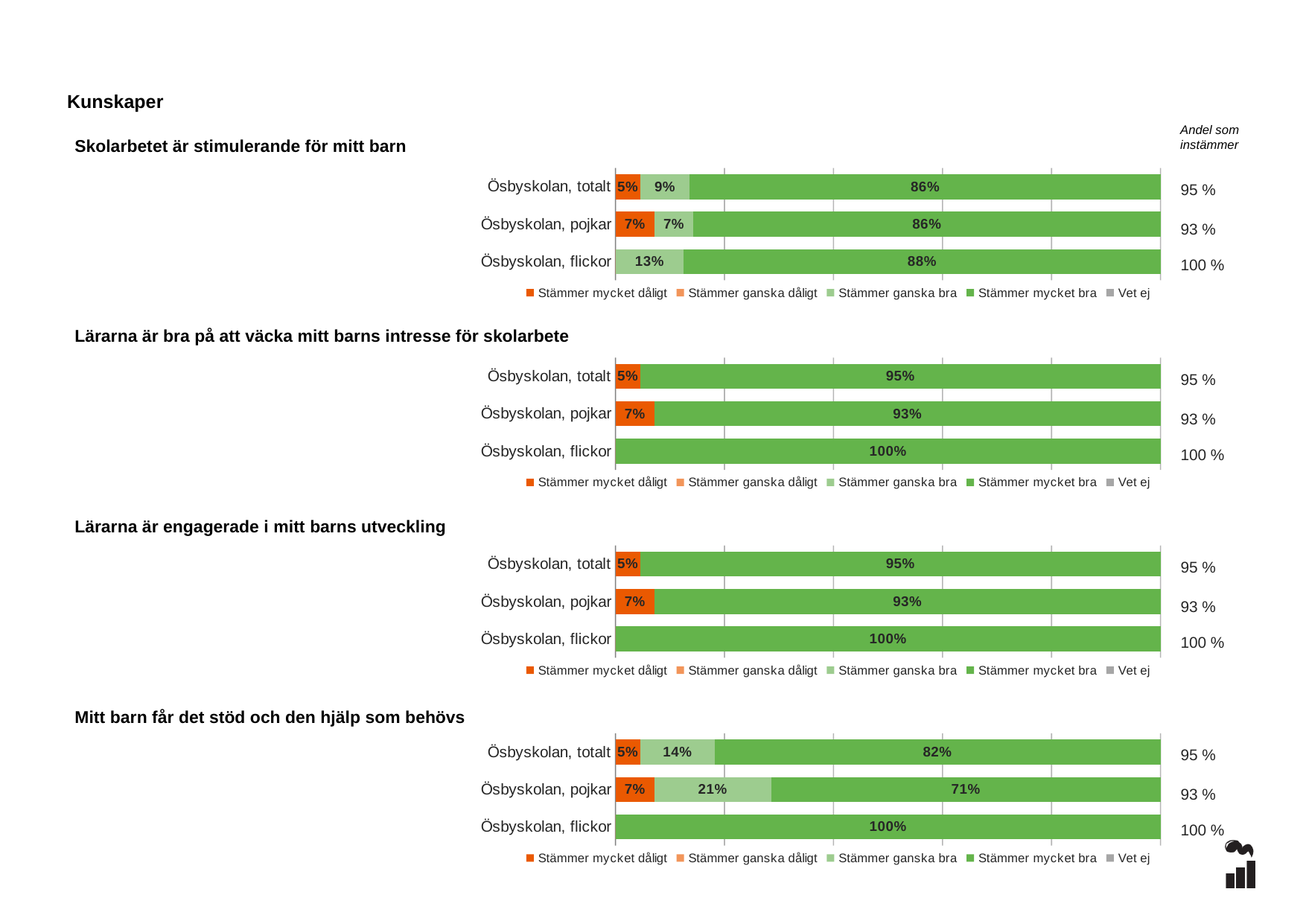
In the chart 'Mitt barn får det stöd och den hjälp som behövs', which category has the highest 'Stämmer mycket bra' value? Ösbyskolan, flickor In the chart 'Skolarbetet är stimulerande för mitt barn', what is the 'Stämmer mycket bra' value for Ösbyskolan, flickor? 88% In the chart 'Lärarna är engagerade i mitt barns utveckling', what is the 'Stämmer mycket dåligt' value for Ösbyskolan, pojkar? 7% In the chart 'Lärarna är bra på att väcka mitt barns intresse för skolarbete', which is larger: the 'Stämmer mycket bra' value for Ösbyskolan, totalt or for Ösbyskolan, pojkar? Ösbyskolan, totalt In the chart 'Mitt barn får det stöd och den hjälp som behövs', which category has the lowest 'Stämmer mycket bra' value? Ösbyskolan, pojkar How many series does the legend of the chart 'Skolarbetet är stimulerande för mitt barn' list? 5 In the chart 'Mitt barn får det stöd och den hjälp som behövs', what is the difference between the 'Stämmer mycket bra' values for Ösbyskolan, totalt and Ösbyskolan, pojkar? 11% What kind of chart is used for 'Mitt barn får det stöd och den hjälp som behövs'? Stacked bar chart In the chart 'Skolarbetet är stimulerande för mitt barn', what is the 'Stämmer ganska bra' value for Ösbyskolan, totalt? 9% What is the 'Andel som instämmer' value shown for Ösbyskolan, pojkar in the chart 'Skolarbetet är stimulerande för mitt barn'? 93 % How many categories are shown in the chart 'Lärarna är engagerade i mitt barns utveckling'? 3 In the chart 'Mitt barn får det stöd och den hjälp som behövs', what is the 'Stämmer ganska bra' value for Ösbyskolan, pojkar? 21%